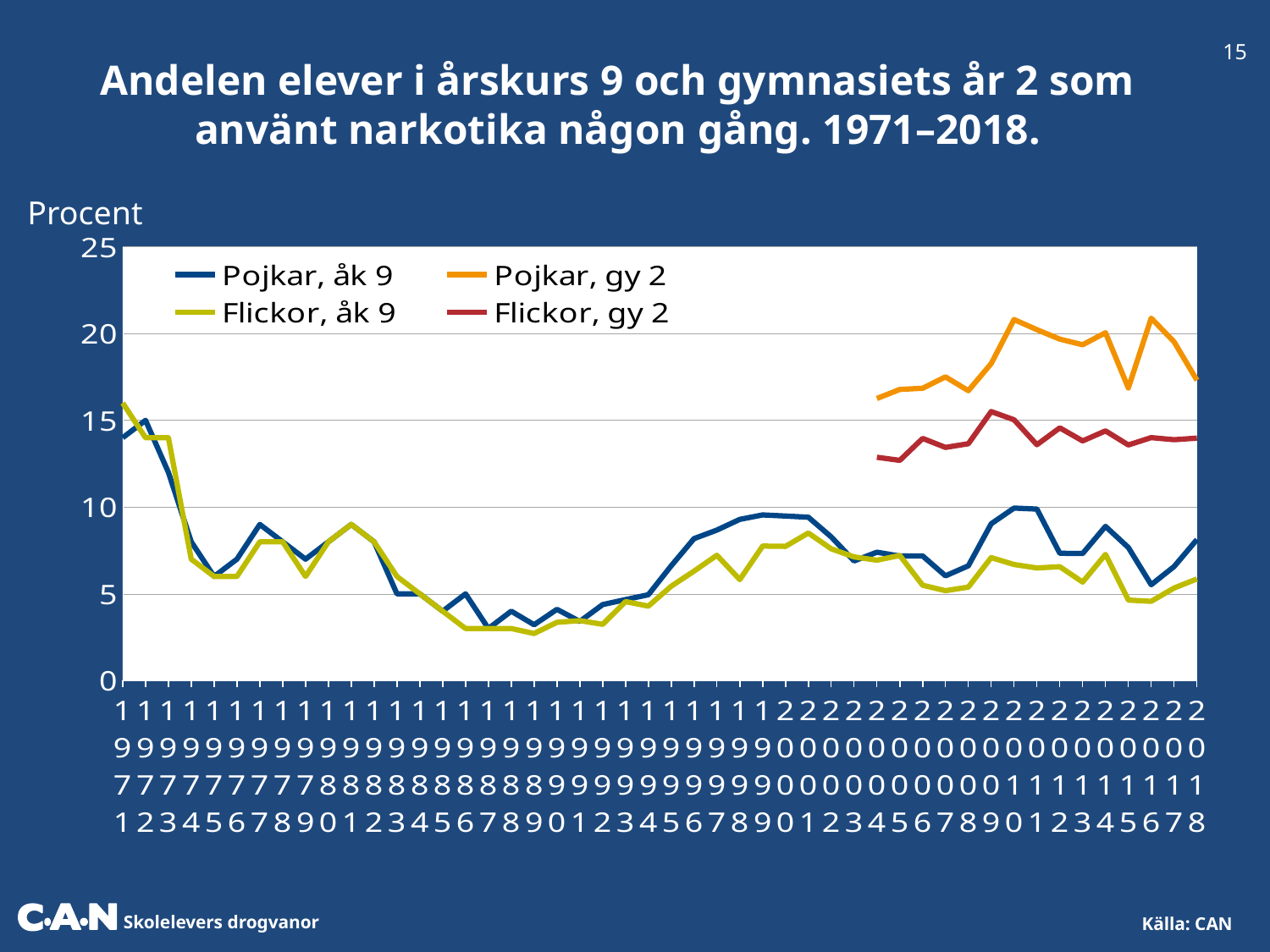
Is the value for Flickor, gy 2 in 2018 greater or less than 10? greater Is the value for Pojkar, gy 2 in 2018 greater or less than 15? greater Is the value for Pojkar, åk 9 in 1971 greater or less than 10? greater In 2018, which is larger: Pojkar, gy 2 or Flickor, gy 2? Pojkar, gy 2 How many years are plotted along the x axis? 48 Does the Pojkar, åk 9 line rise or fall from 1971 to 1975? fall What is the label on the vertical axis? Procent How many series does the legend list? 4 Which series reaches the highest value on the chart? Pojkar, gy 2 Which series are listed in the legend? Pojkar, åk 9; Pojkar, gy 2; Flickor, åk 9; Flickor, gy 2 What kind of chart is shown on the slide? line chart